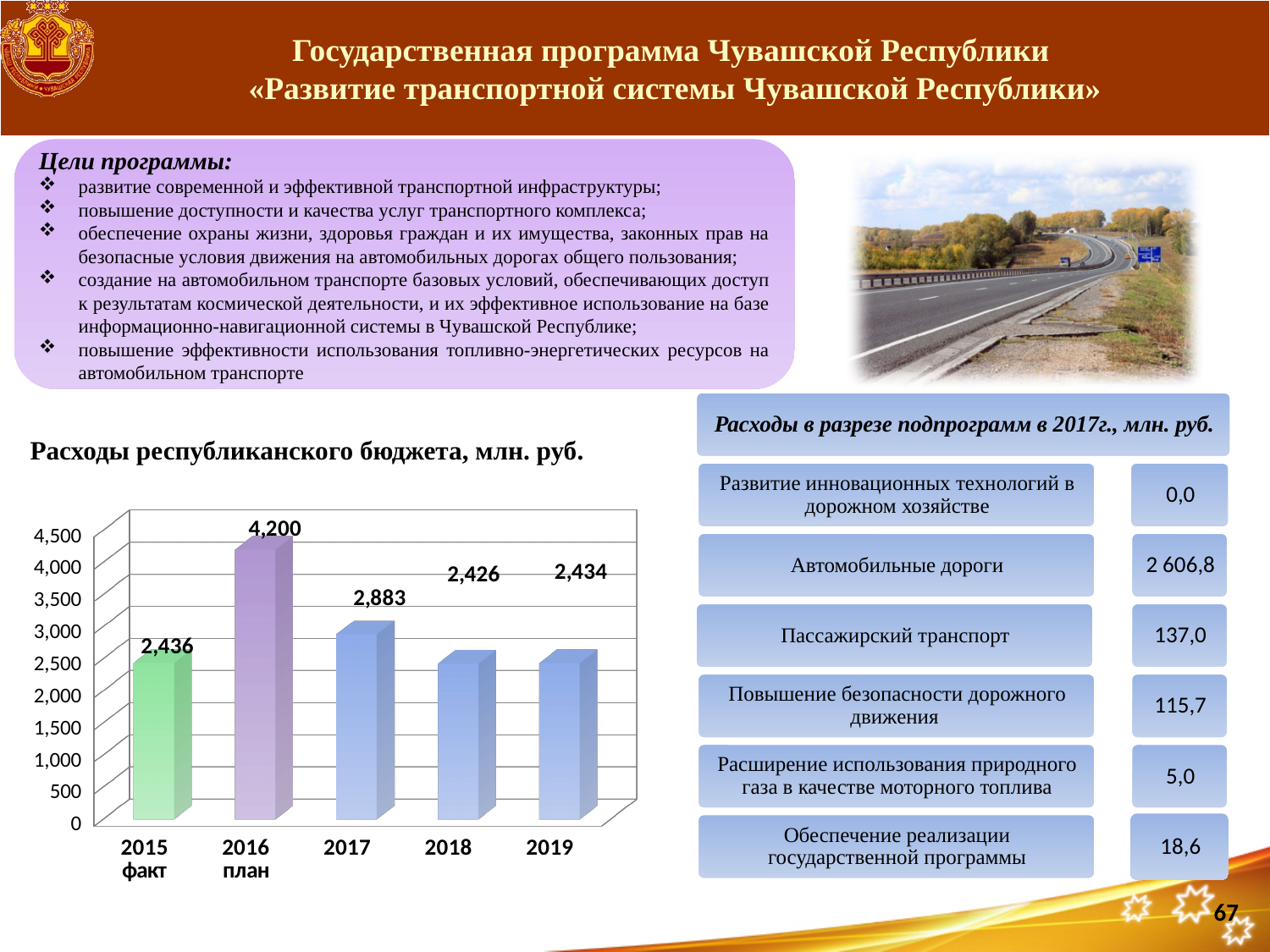
Which year has the lowest value in the chart? 2018 What is the difference between the values for 2016 план and 2015 факт? 1,764 What is the difference between the values for 2016 план and 2017? 1,317 Is the value for 2017 greater or less than 2,500? greater What kind of chart is shown on the slide? bar chart How many years are shown on the x axis of the chart? 5 What is the value for 2016 план in the chart 'Расходы республиканского бюджета, млн. руб.'? 4,200 What is the value for 2015 факт in the chart? 2,436 What is the value for 2019 in the chart? 2,434 Which is larger, the value for 2017 or the value for 2018? 2017 What is the value for 2017 in the chart? 2,883 Which year has the highest value in the chart? 2016 план